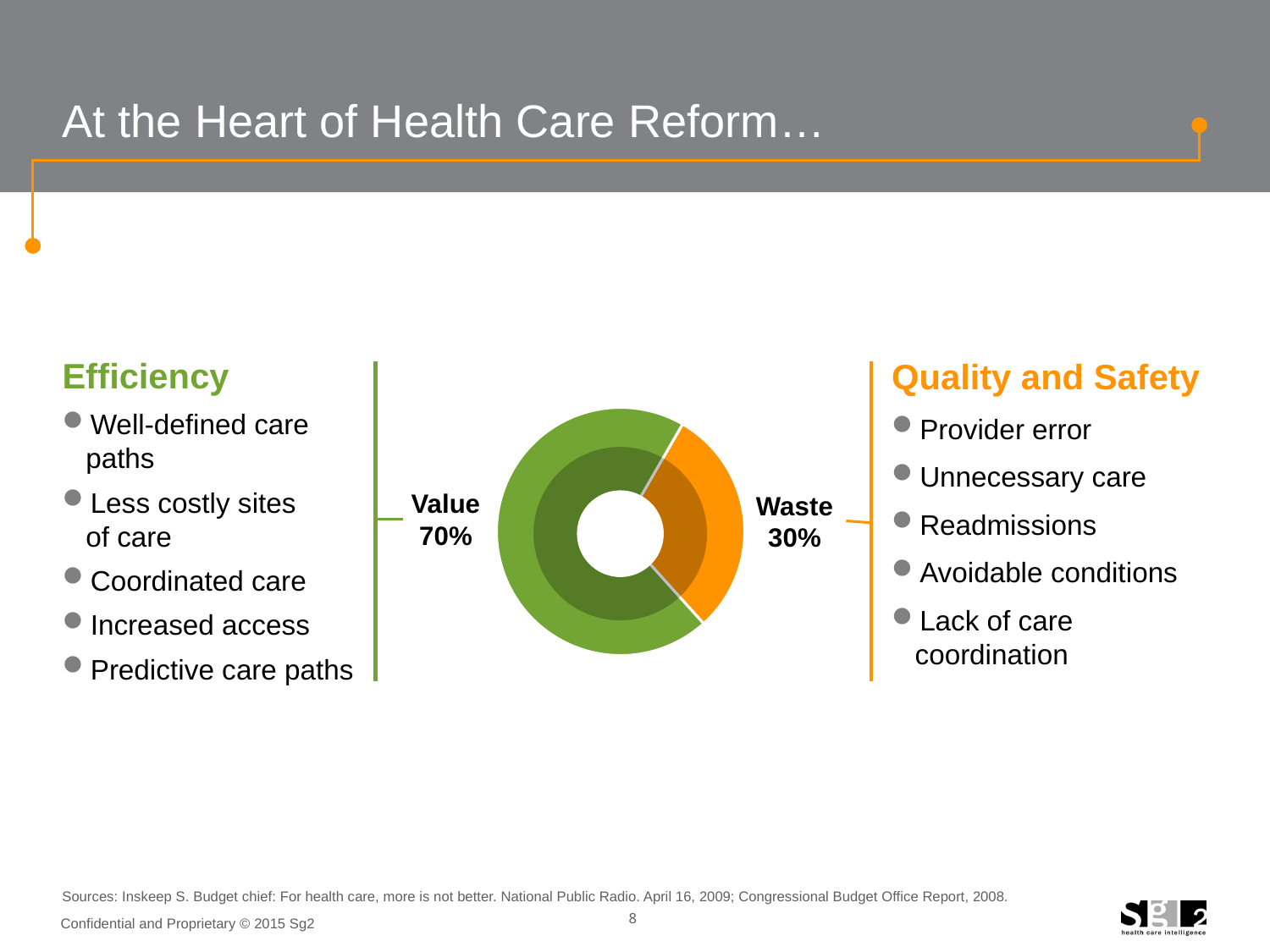
How many segments does the donut chart have? 2 What is the total of the two segments shown in the donut chart? 100% Which segment of the donut chart is the largest? Value Which segment of the donut chart is the smallest? Waste What share of the donut chart is labelled Value? 70% What type of chart is shown on the slide? Donut (pie) chart Which is larger in the donut chart, Value or Waste? Value What colour is the Value segment of the donut chart? Green What share of the donut chart is labelled Waste? 30% What colour is the Waste segment of the donut chart? Orange What is the difference in percentage points between the Value and Waste segments? 40 percentage points